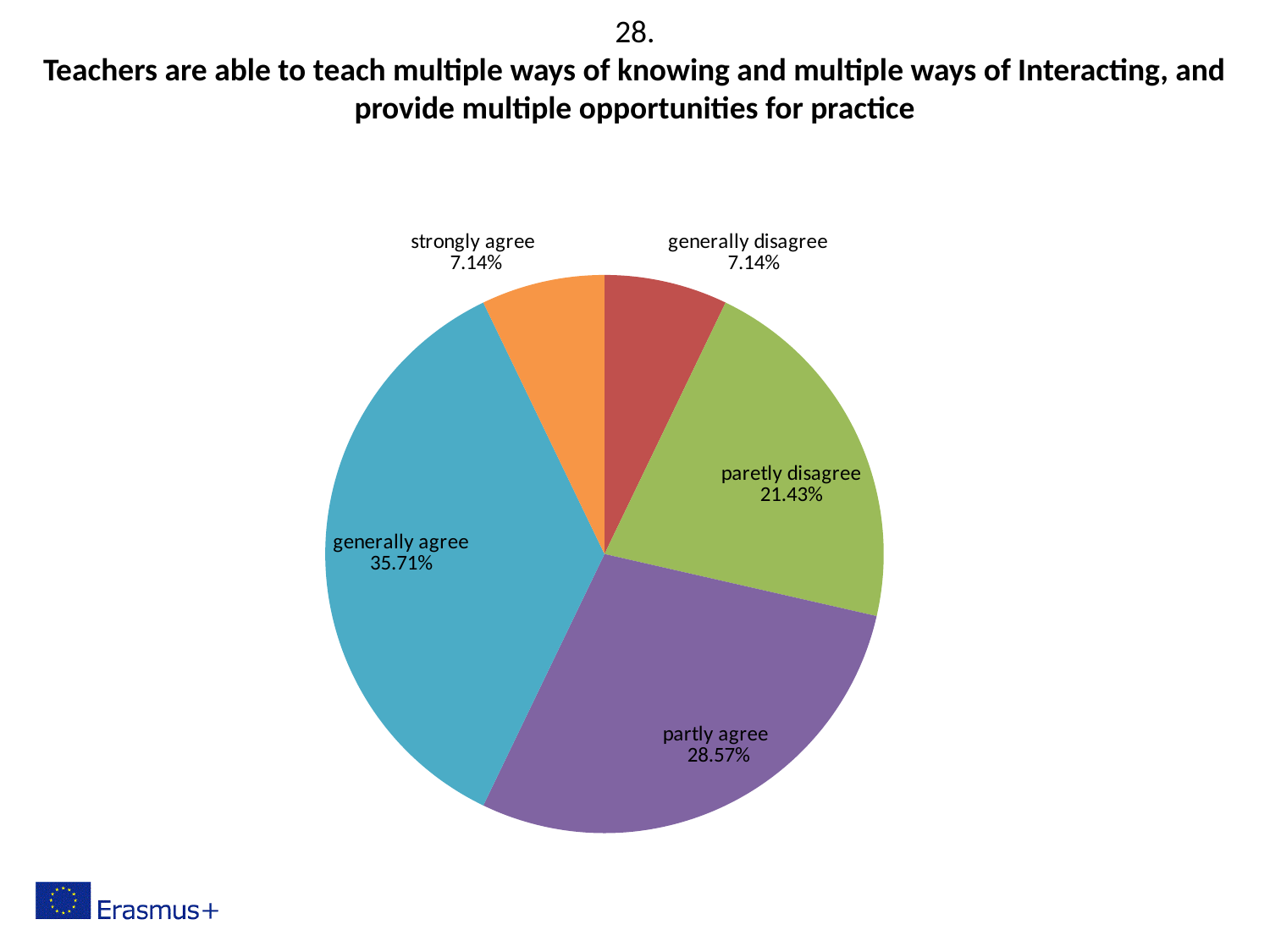
What share of the pie does "generally agree" represent? 35.71% What share of the pie does "paretly disagree" represent? 21.43% What share of the pie does "partly agree" represent? 28.57% Which is larger, the share for "partly agree" or the share for "paretly disagree"? partly agree How many slices does the pie chart have? 5 Which category has the largest slice of the pie? generally agree What is the difference in percentage points between "generally agree" and "partly agree"? 7.14 What is the difference in percentage points between "paretly disagree" and "strongly agree"? 14.29 What colour is the "generally agree" slice? blue What kind of chart is shown on the slide? pie chart